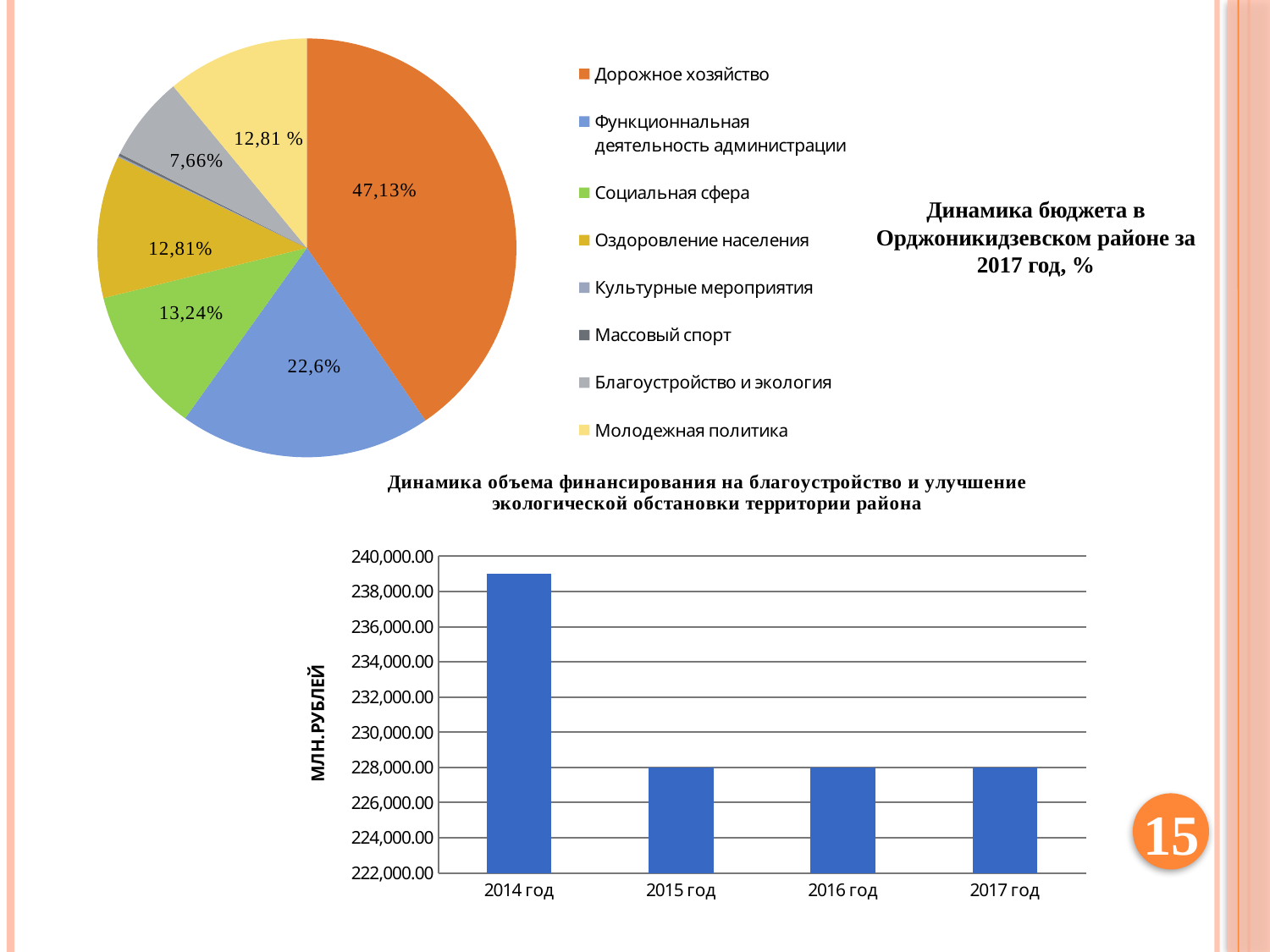
What kind of chart is the top chart titled 'Динамика бюджета в Орджоникидзевском районе за 2017 год, %'? pie chart In the pie chart 'Динамика бюджета в Орджоникидзевском районе за 2017 год, %', what share does Дорожное хозяйство have? 47,13% In the pie chart 'Динамика бюджета в Орджоникидзевском районе за 2017 год, %', what share does Социальная сфера have? 13,24% What kind of chart is the bottom chart titled 'Динамика объема финансирования на благоустройство и улучшение экологической обстановки территории района'? bar chart In the bottom bar chart 'Динамика объема финансирования на благоустройство и улучшение экологической обстановки территории района', what is the label on the vertical axis? млн.рублей In the pie chart 'Динамика бюджета в Орджоникидзевском районе за 2017 год, %', which category has the largest slice? Дорожное хозяйство How many entries does the legend of the pie chart 'Динамика бюджета в Орджоникидзевском районе за 2017 год, %' list? 8 In the bottom bar chart 'Динамика объема финансирования на благоустройство и улучшение экологической обстановки территории района', what is the value for 2015 год? 228,000.00 In the pie chart 'Динамика бюджета в Орджоникидзевском районе за 2017 год, %', what share does Функциональная деятельность администрации have? 22,6% In the pie chart 'Динамика бюджета в Орджоникидзевском районе за 2017 год, %', what is the difference between the shares of Дорожное хозяйство and Функциональная деятельность администрации? 24,53% In the bottom bar chart 'Динамика объема финансирования на благоустройство и улучшение экологической обстановки территории района', is the value for 2014 год greater or less than 238,000.00? greater How many bars are shown in the bottom bar chart 'Динамика объема финансирования на благоустройство и улучшение экологической обстановки территории района'? 4